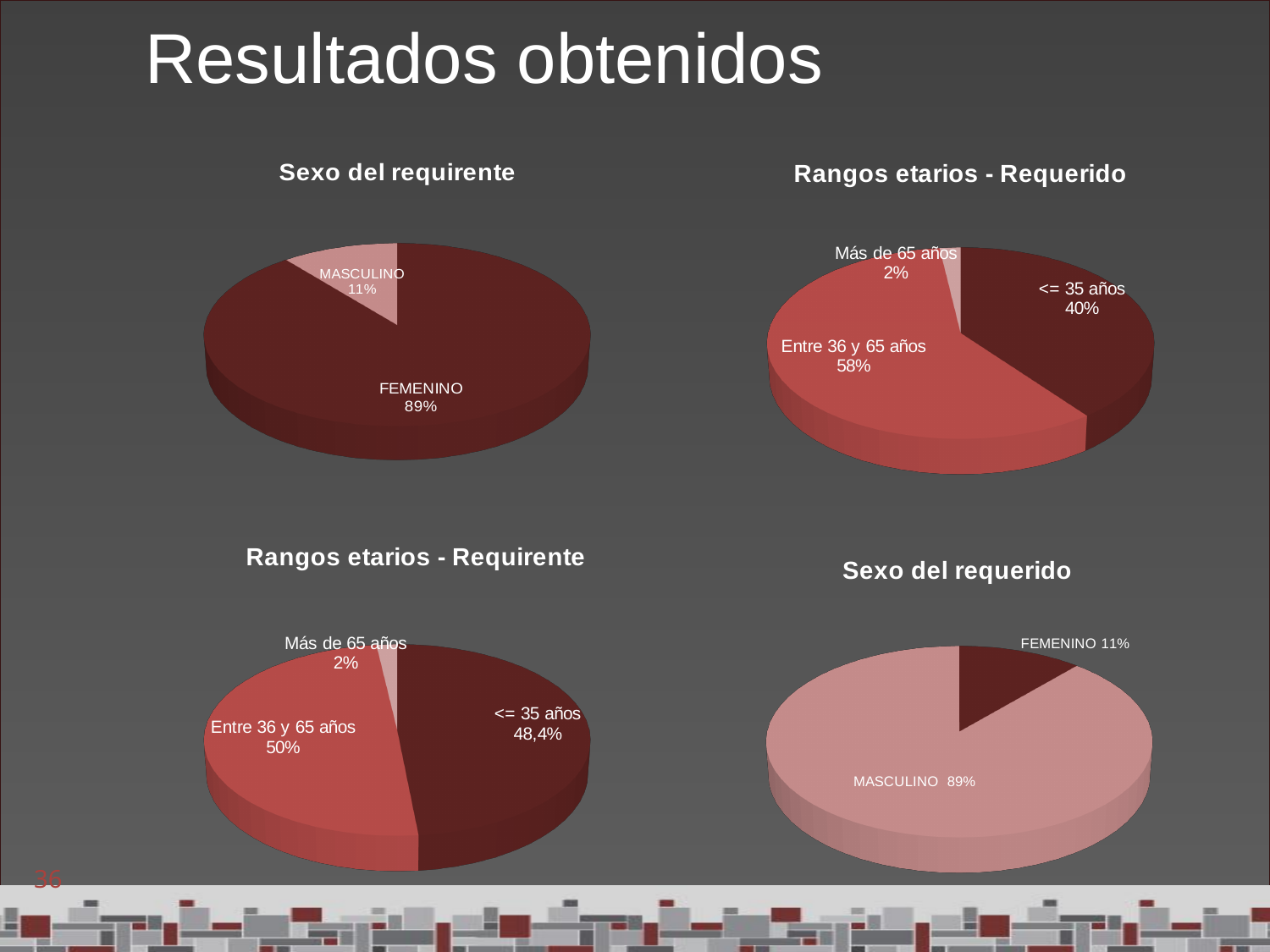
In the 'Rangos etarios - Requirente' chart, which age range has the largest share? Entre 36 y 65 años In the 'Sexo del requerido' chart, what share is MASCULINO? 89% In the 'Rangos etarios - Requirente' chart, what share is '<= 35 años'? 48,4% In the 'Sexo del requirente' chart, what share is FEMENINO? 89% In the 'Sexo del requerido' chart, which is larger, FEMENINO or MASCULINO? MASCULINO How many charts are on the slide? 4 In the 'Sexo del requirente' chart, what share is MASCULINO? 11% In the 'Rangos etarios - Requerido' chart, what is the difference between the '<= 35 años' and 'Entre 36 y 65 años' shares? 18% What kind of chart is 'Sexo del requerido'? Pie chart In the 'Rangos etarios - Requirente' chart, how many age ranges are shown? 3 In the 'Rangos etarios - Requerido' chart, what share is 'Entre 36 y 65 años'? 58% In the 'Rangos etarios - Requerido' chart, which age range has the smallest share? Más de 65 años